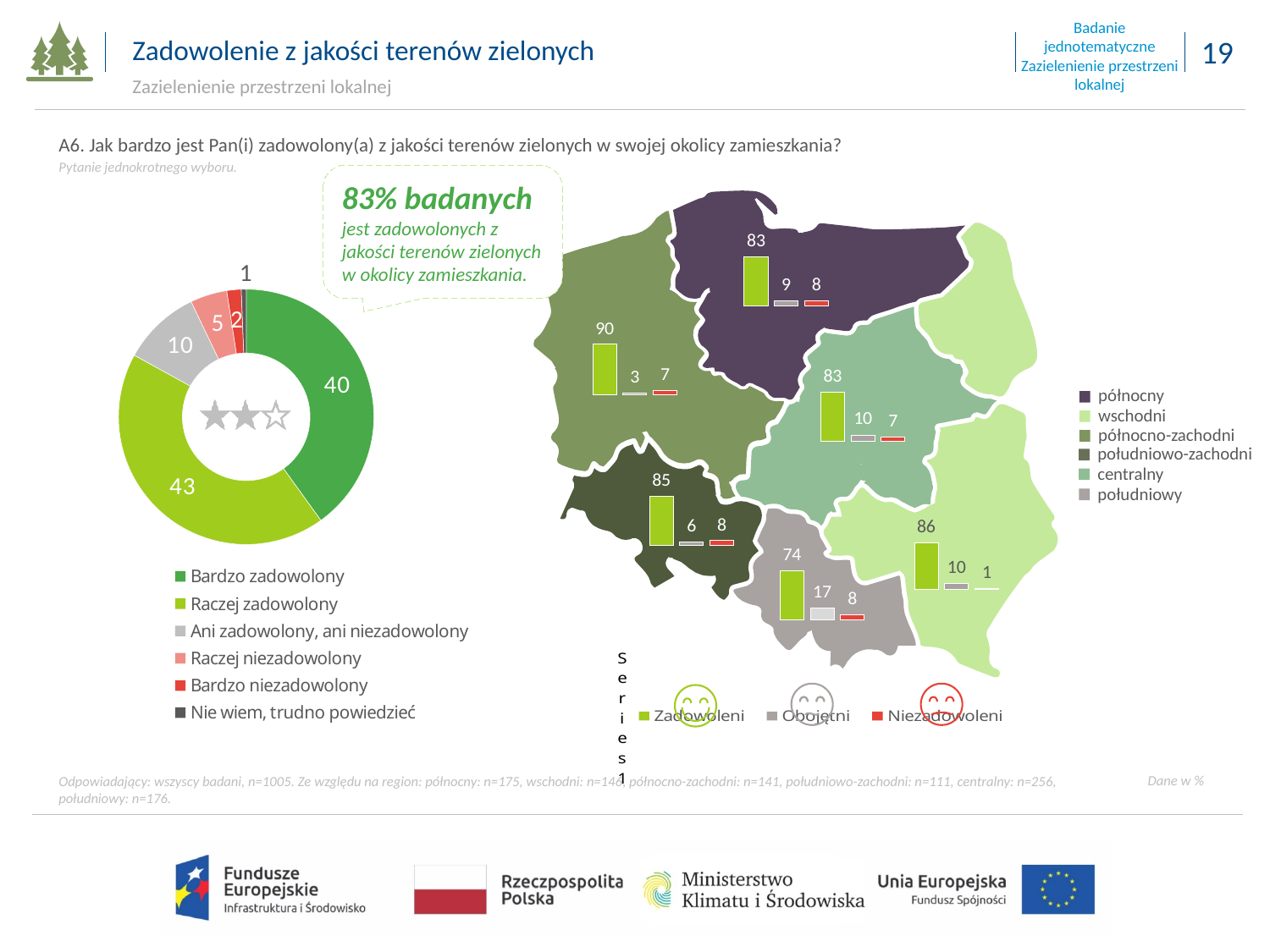
On the map chart on the right, what is the "Niezadowoleni" value for the wschodni region? 1 On the donut chart on the left, what is the difference between "Ani zadowolony, ani niezadowolony" and "Raczej niezadowolony"? 5 On the map chart on the right, which region has the highest "Zadowoleni" value? północno-zachodni On the map chart on the right, which is larger: the "Obojętni" value for południowy or for centralny? południowy What kind of chart is the chart on the left of the slide? Donut chart On the donut chart on the left, which category has the lowest value? Nie wiem, trudno powiedzieć How many categories does the legend of the donut chart on the left list? 6 How many series does the legend at the bottom of the map chart on the right list? 3 On the donut chart on the left, which category has the highest value? Raczej zadowolony On the donut chart on the left, what is the value for "Bardzo zadowolony"? 40 On the map chart on the right, what is the "Zadowoleni" value for the południowy region? 74 On the donut chart on the left, what is the value for "Raczej zadowolony"? 43